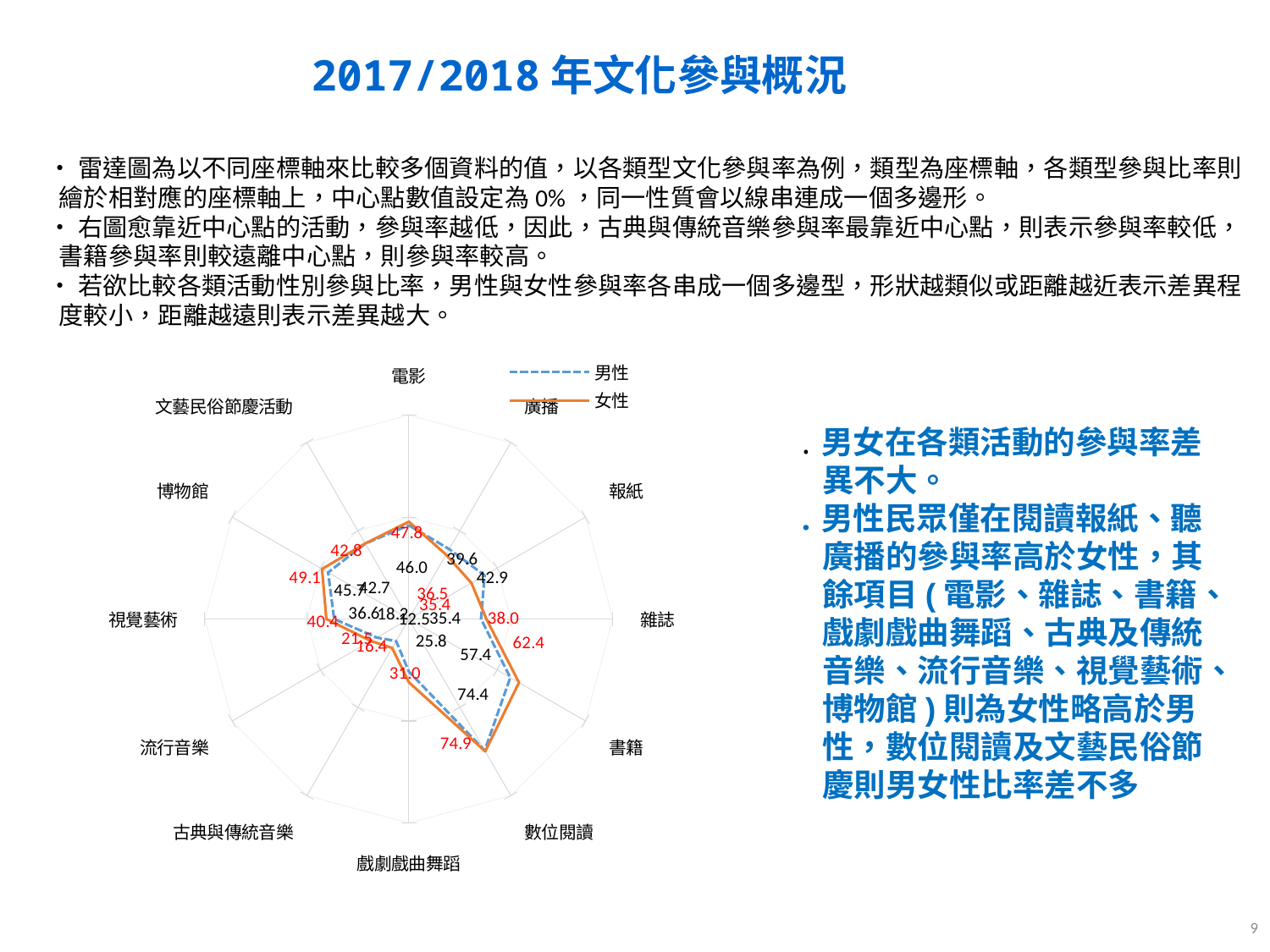
How many series does the legend of the radar chart list? 2 Which series is drawn with a dashed blue line in the radar chart? 男性 What is the 女性 value for 雜誌 on the radar chart? 38.0 What is the 男性 value for 視覺藝術 on the radar chart? 36.6 What is the 女性 value for 博物館 on the radar chart? 49.1 How many categories (axes) does the radar chart have? 12 What is the 女性 participation rate for 電影 on the radar chart? 47.8 What kind of chart is shown on the slide? Radar chart For 廣播, which series has the higher value, 男性 or 女性? 男性 What is the 男性 participation rate for 電影 on the radar chart? 46.0 What is the difference between the 女性 and 男性 values for 電影? 1.8 Which category lies closest to the centre of the radar chart, i.e. has the lowest participation rate? 古典與傳統音樂